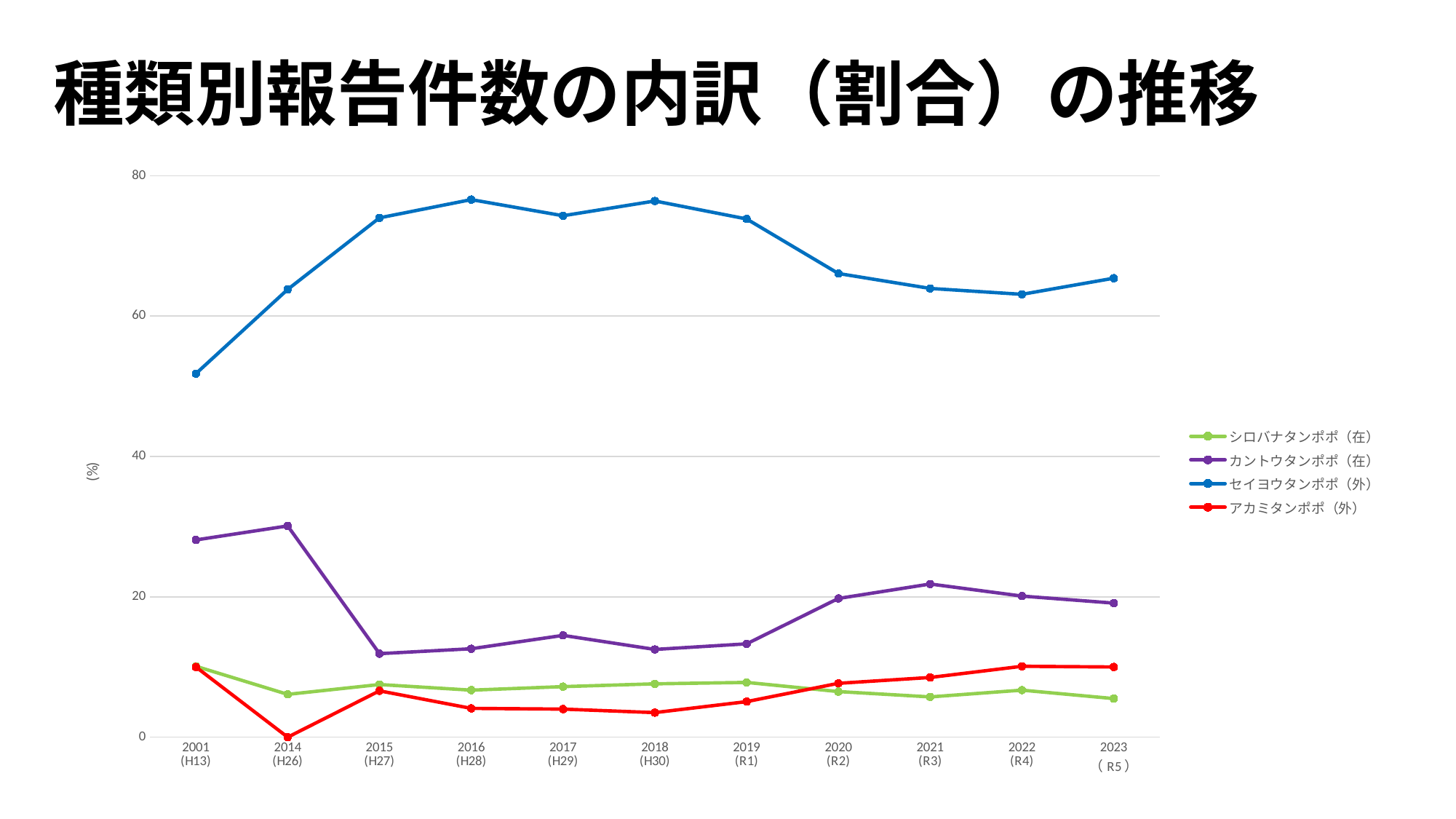
In which year is the value for セイヨウタンポポ（外） lowest? 2001 (H13) What kind of chart is shown on the slide? line chart How many years are plotted along the x axis? 11 How many series does the legend list? 4 Which series has the highest value in 2023 (R5)? セイヨウタンポポ（外） In 2023 (R5), which is larger: アカミタンポポ（外） or シロバナタンポポ（在）? アカミタンポポ（外） Is the value for カントウタンポポ（在） in 2014 (H26) greater or less than 20? greater In which year is the value for カントウタンポポ（在） highest? 2014 (H26) Is the value for カントウタンポポ（在） in 2015 (H27) greater or less than 20? less Is the value for セイヨウタンポポ（外） in 2001 (H13) greater or less than 60? less Does the value for セイヨウタンポポ（外） rise or fall from 2001 (H13) to 2016 (H28)? rise